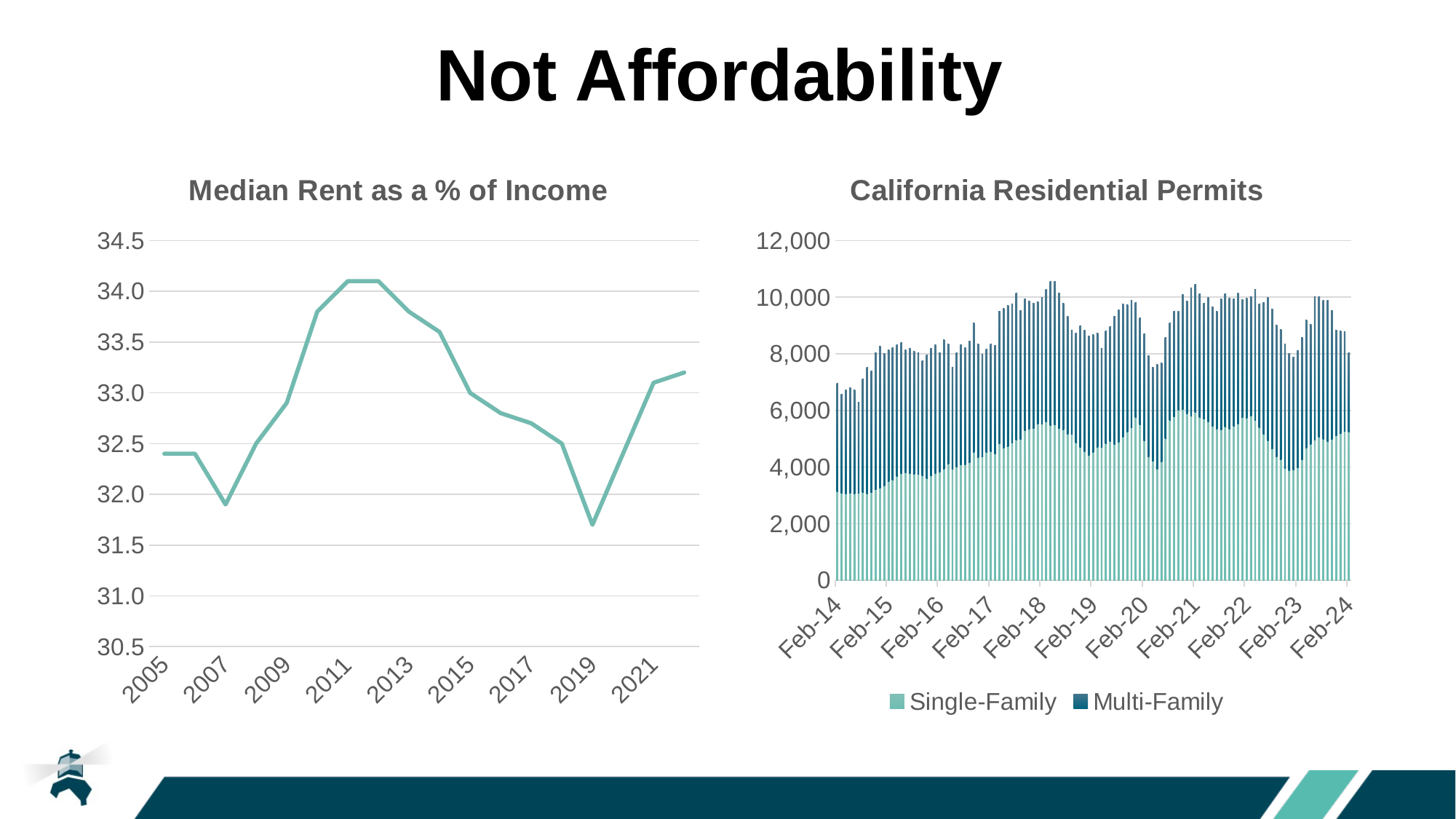
What kind of chart is the "Median Rent as a % of Income" chart on the left? line chart In the "Median Rent as a % of Income" chart, is the value for 2019 greater or less than 32.0? less In the "California Residential Permits" chart, is the total for Feb-14 greater or less than 8,000? less In the "Median Rent as a % of Income" chart, which is larger, the value for 2011 or the value for 2005? 2011 In the "Median Rent as a % of Income" chart, which year has the lowest value? 2019 How many series does the legend of the "California Residential Permits" chart list? 2 What are the two series named in the legend of the "California Residential Permits" chart? Single-Family and Multi-Family What kind of chart is the "California Residential Permits" chart on the right? bar chart In the "Median Rent as a % of Income" chart, is the value for 2015 greater or less than 33.5? less In the "California Residential Permits" chart, which series is shown in the lighter teal colour at the bottom of each bar? Single-Family In the "Median Rent as a % of Income" chart, does the line rise or fall between 2007 and 2011? rise